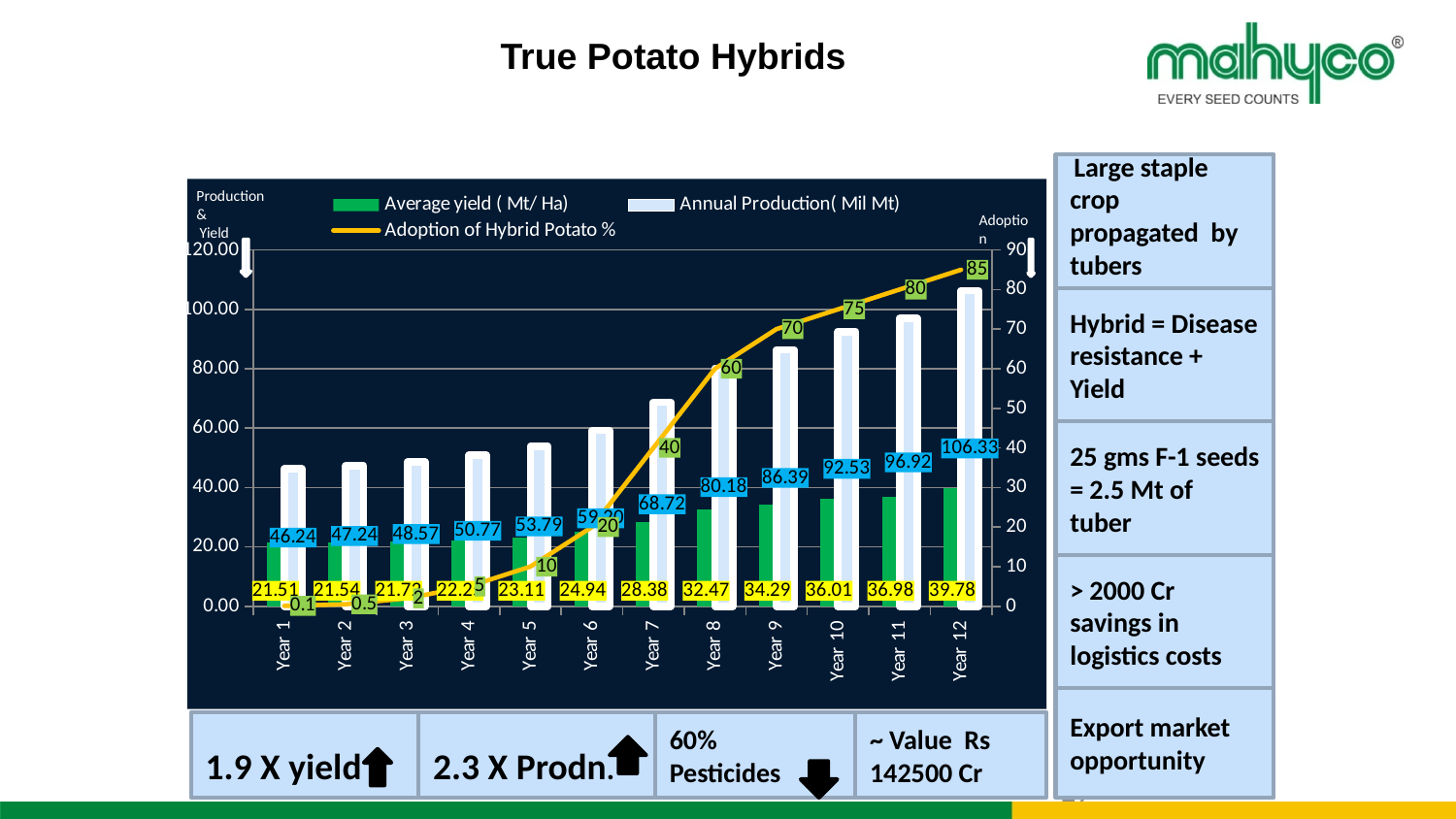
What is the Adoption of Hybrid Potato % for Year 8? 60 Which is larger, the Average yield for Year 10 or for Year 5? Year 10 What is the Average yield (Mt/Ha) for Year 1? 21.51 What is the difference in Annual Production (Mil Mt) between Year 12 and Year 1? 60.09 Which year has the lowest Annual Production (Mil Mt)? Year 1 What is the Annual Production (Mil Mt) for Year 12? 106.33 What colour are the Average yield (Mt/Ha) bars? green What is the Annual Production (Mil Mt) for Year 7? 68.72 How many series does the legend list? 3 Does the Adoption of Hybrid Potato % rise or fall from Year 1 to Year 12? rise Which year has the highest Average yield (Mt/Ha)? Year 12 How many years are shown on the x axis? 12